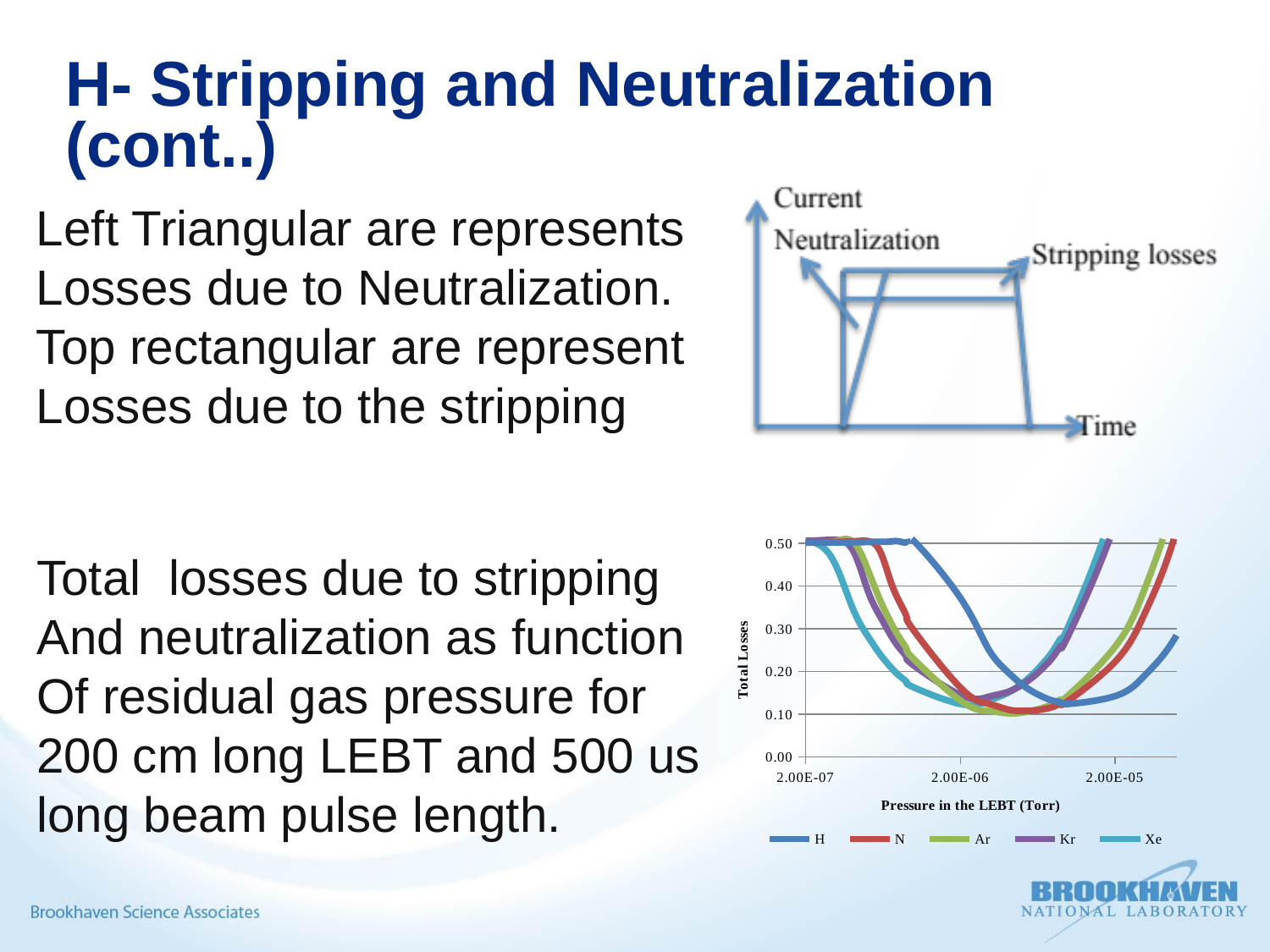
In the Total Losses chart, how does the H series change as pressure increases from 2.00E-07 to 2.00E-05 Torr? it falls then rises What kind of chart is the chart at the bottom right of the slide? line chart In the Total Losses chart, is the value of the H series at 2.00E-06 Torr greater or less than 0.30? greater In the Total Losses chart, what is the value of the H series at a pressure of 2.00E-07 Torr? 0.50 In the Total Losses chart, is the lowest value reached by the H series greater or less than 0.20? less In the Total Losses chart, is the lowest value reached by the Xe series greater or less than 0.20? less What are the series names in the legend of the Total Losses chart? H, N, Ar, Kr, Xe In the Total Losses chart, which series begins to drop from 0.50 at the lowest pressure? Xe How many series does the legend of the Total Losses chart list? 5 What is the x-axis title of the Total Losses chart? Pressure in the LEBT (Torr) In the Total Losses chart, which series reaches its minimum at the highest pressure? H In the Total Losses chart, at 2.00E-05 Torr, is the value of the H series greater or less than the value of the N series? less